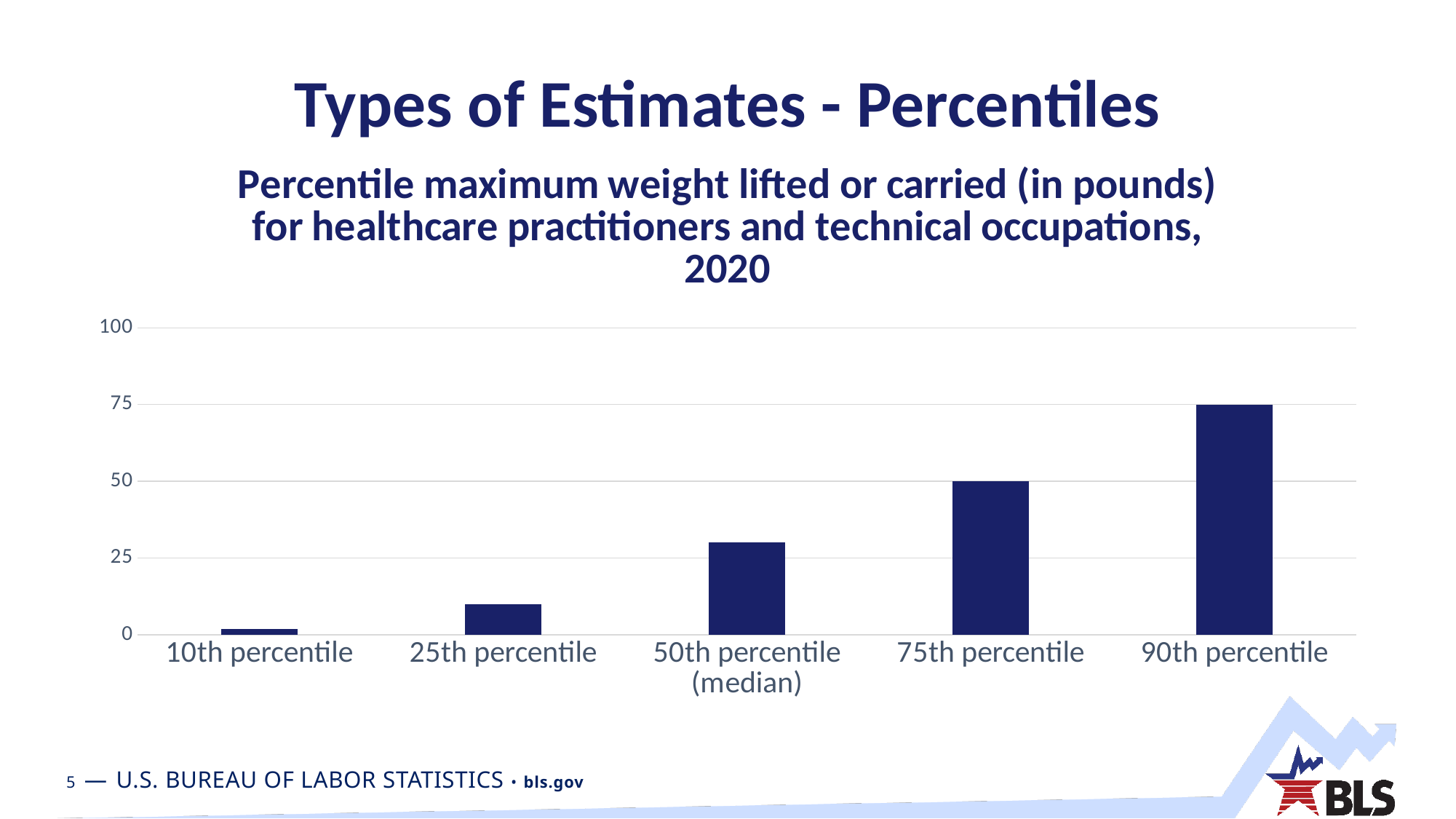
Do the values rise or fall from the 10th percentile to the 90th percentile along the x axis? rise Is the value for the 25th percentile greater or less than 25? less What is the value for the 75th percentile? 50 What type of chart is shown on the slide? bar chart Is the value for the 50th percentile (median) greater or less than 25? greater Is the value for the 50th percentile (median) greater or less than 50? less Which percentile has the highest maximum weight lifted or carried? 90th percentile Which percentile has the lowest maximum weight lifted or carried? 10th percentile What is the difference between the 90th percentile and the 75th percentile values? 25 Which is larger, the value for the 25th percentile or the 50th percentile (median)? 50th percentile (median) What is the value for the 90th percentile? 75 How many percentile categories are plotted in the chart? 5